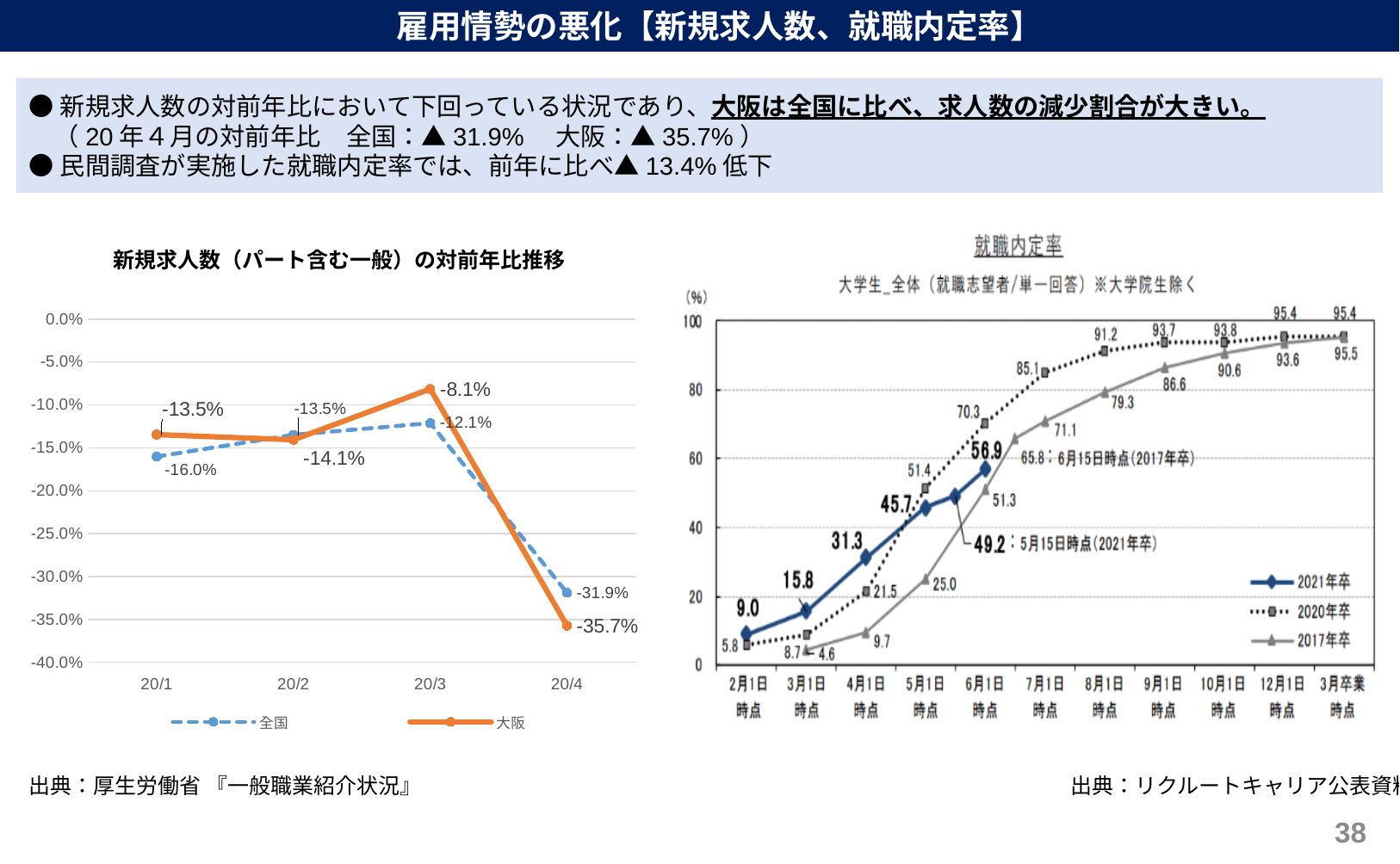
In the left chart (新規求人数の対前年比推移), what is the value for 大阪 at 20/4? -35.7% In the left chart (新規求人数の対前年比推移), what is the difference between 全国 and 大阪 at 20/4? 3.8 percentage points In the left chart (新規求人数の対前年比推移), how many series does the legend list? 2 In the right chart (就職内定率), what is the value for 2021年卒 at 6月1日時点? 56.9 In the right chart (就職内定率), which series has the higher value at 5月1日時点, 2021年卒 or 2020年卒? 2020年卒 In the left chart (新規求人数の対前年比推移), which series has the higher value at 20/3, 全国 or 大阪? 大阪 In the left chart (新規求人数の対前年比推移), at which time point is the 大阪 value lowest? 20/4 In the left chart (新規求人数の対前年比推移), how many time points are plotted on the x axis? 4 In the right chart (就職内定率), how many series does the legend list? 3 In the left chart (新規求人数の対前年比推移), what is the value for 全国 at 20/1? -16.0% What kind of chart is the left chart (新規求人数の対前年比推移)? Line chart In the right chart (就職内定率), what is the value for 2020年卒 at 3月卒業時点? 95.4